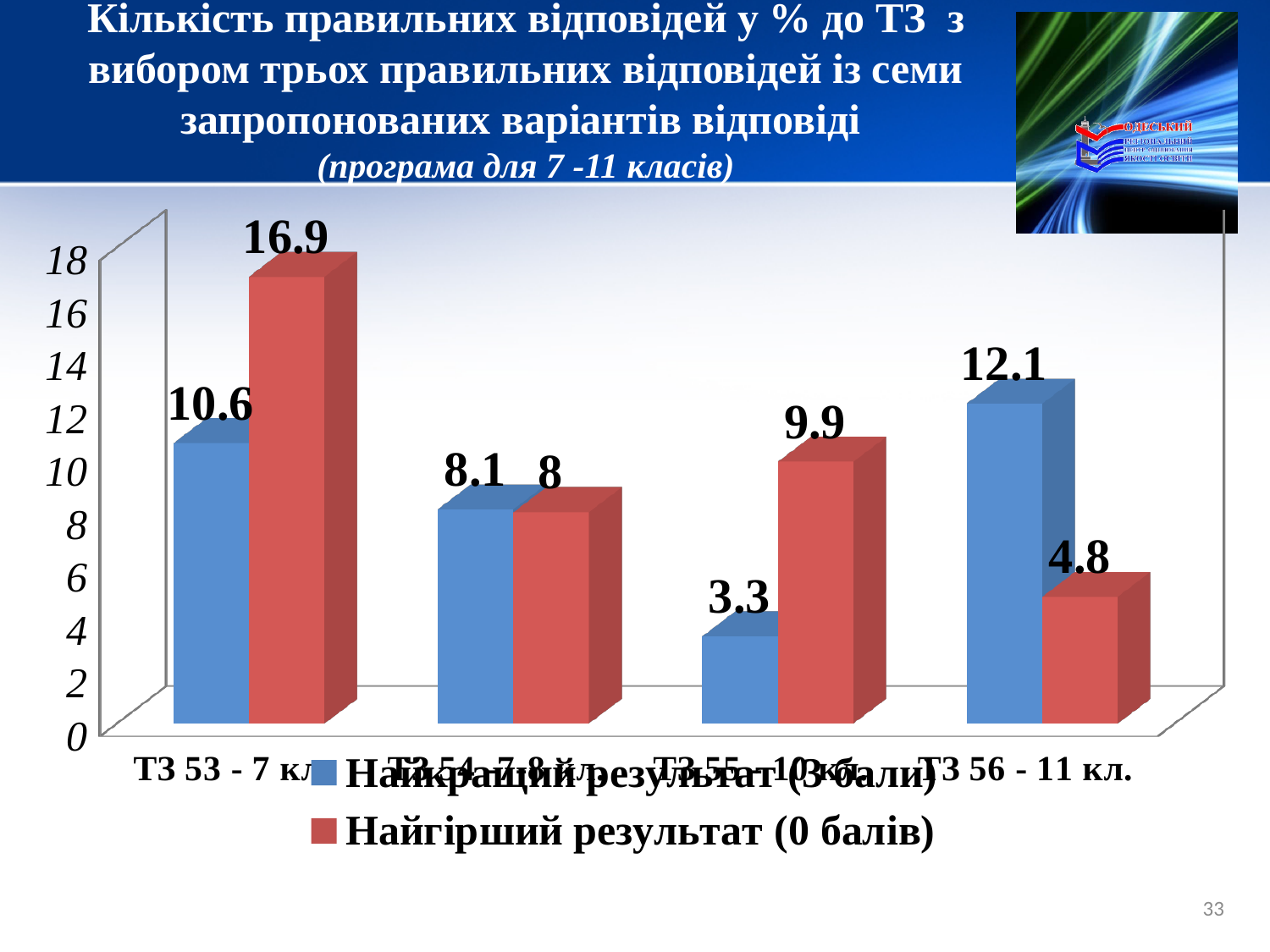
How many series does the legend list? 2 Which colour represents "Найкращий результат (3 бали)" in the chart? blue What is the value of "Найгірший результат (0 балів)" for ТЗ 53 - 7 кл.? 16.9 What is the value of "Найкращий результат (3 бали)" for ТЗ 55? 3.3 What is the difference between the two series for ТЗ 56 - 11 кл.? 7.3 For ТЗ 55, which series has the larger value: "Найкращий результат (3 бали)" or "Найгірший результат (0 балів)"? Найгірший результат (0 балів) What type of chart is shown on the slide? bar chart What is the difference between "Найкращий результат (3 бали)" and "Найгірший результат (0 балів)" for ТЗ 54? 0.1 Which category has the highest value for "Найгірший результат (0 балів)"? ТЗ 53 - 7 кл. What is the value of "Найкращий результат (3 бали)" for ТЗ 56 - 11 кл.? 12.1 Which category has the lowest value for "Найкращий результат (3 бали)"? ТЗ 55 How many categories are shown on the x axis? 4